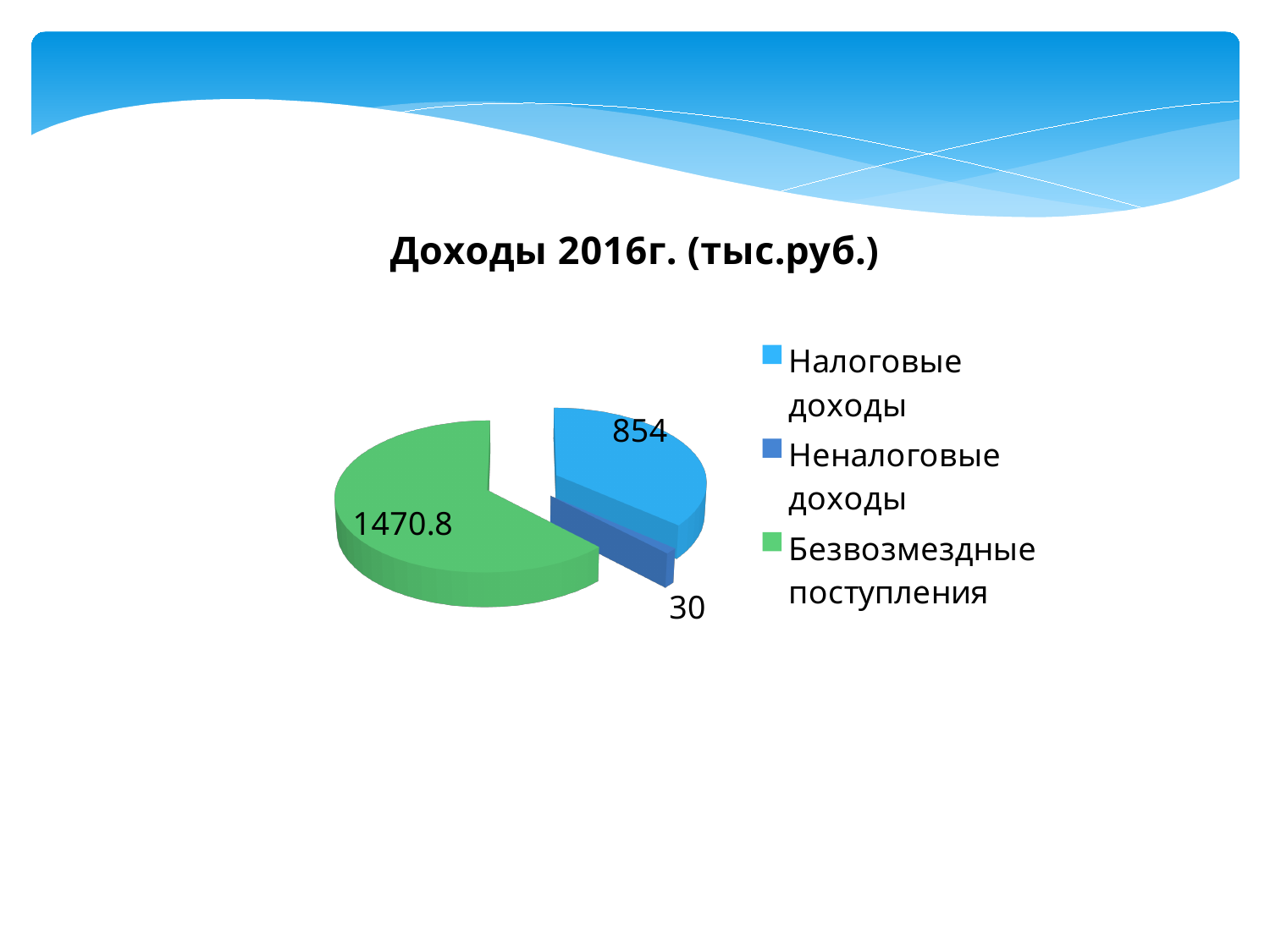
What is the difference between Безвозмездные поступления and Налоговые доходы? 616.8 What is the title of the chart? Доходы 2016г. (тыс.руб.) What is the value for Неналоговые доходы? 30 What is the value for Безвозмездные поступления? 1470.8 Which is larger, Налоговые доходы or Неналоговые доходы? Налоговые доходы What colour is the slice for Безвозмездные поступления? Green What is the value for Налоговые доходы? 854 Which category has the largest slice? Безвозмездные поступления What is the difference between Налоговые доходы and Неналоговые доходы? 824 How many slices does the pie chart have? 3 What type of chart is shown on the slide? Pie chart Which category has the smallest slice? Неналоговые доходы